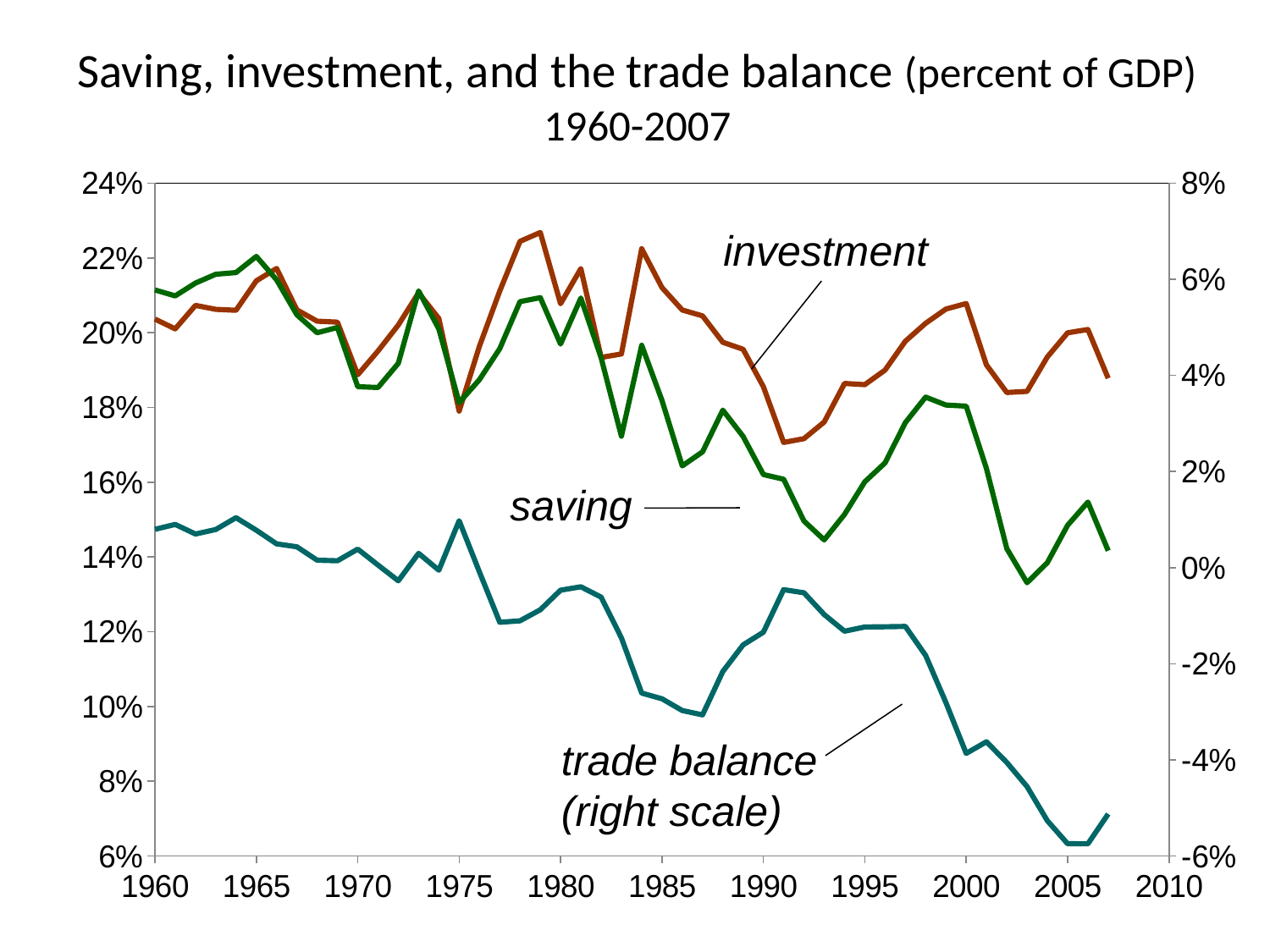
Is the value for saving in 2003 greater or less than 14%? less Which series is plotted against the right scale? trade balance What period does the chart title say the data covers? 1960-2007 In 2007, which is larger, investment or saving? investment Is the trade balance in 2005 (right scale) greater or less than -4%? less Does the trade balance rise or fall between 1997 and 2005? fall Is the value for investment in 1979 greater or less than 22%? greater What kind of chart is shown on the slide? line chart How many series are plotted on the chart? 3 In 1965, which is larger, saving or investment? saving